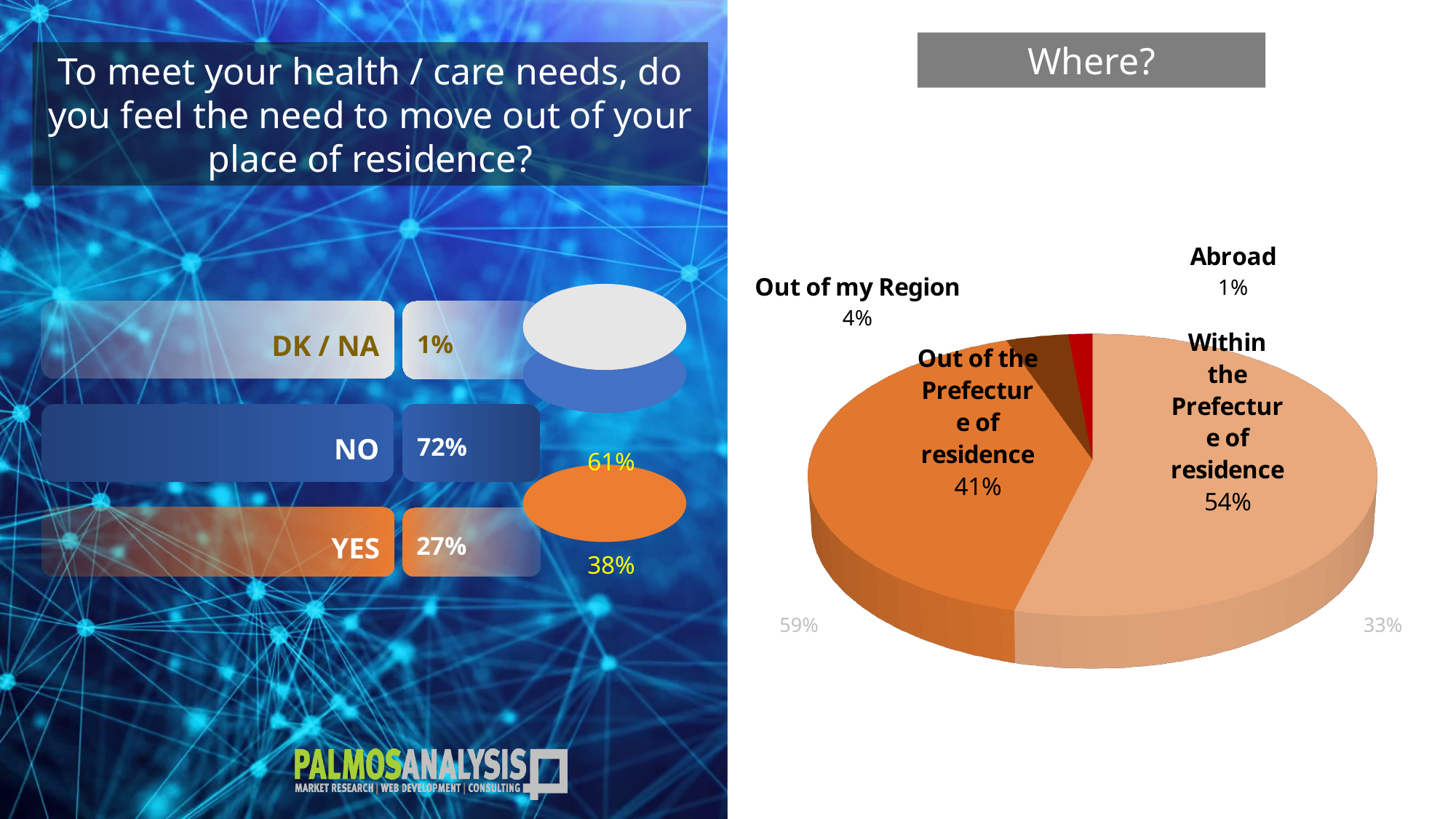
In the 'Where?' pie chart, what is the difference in percentage points between 'Within the Prefecture of residence' and 'Out of the Prefecture of residence'? 13 How many slices does the 'Where?' pie chart have? 4 In the 'Where?' pie chart, what share is shown for 'Within the Prefecture of residence'? 54% In the left chart on the slide, which answer has the highest percentage: YES, NO or DK / NA? NO In the left chart on the slide, what percentage is shown for 'NO'? 72% In the 'Where?' pie chart, which slice is the smallest? Abroad In the 'Where?' pie chart, what share is shown for 'Out of the Prefecture of residence'? 41% In the 'Where?' pie chart, which slice is the largest? Within the Prefecture of residence In the 'Where?' pie chart, what share is shown for 'Abroad'? 1% In the left chart on the slide, what percentage is shown for 'YES'? 27% In the 'Where?' pie chart, what share is shown for 'Out of my Region'? 4% What kind of chart is the 'Where?' chart on the right of the slide? Pie chart